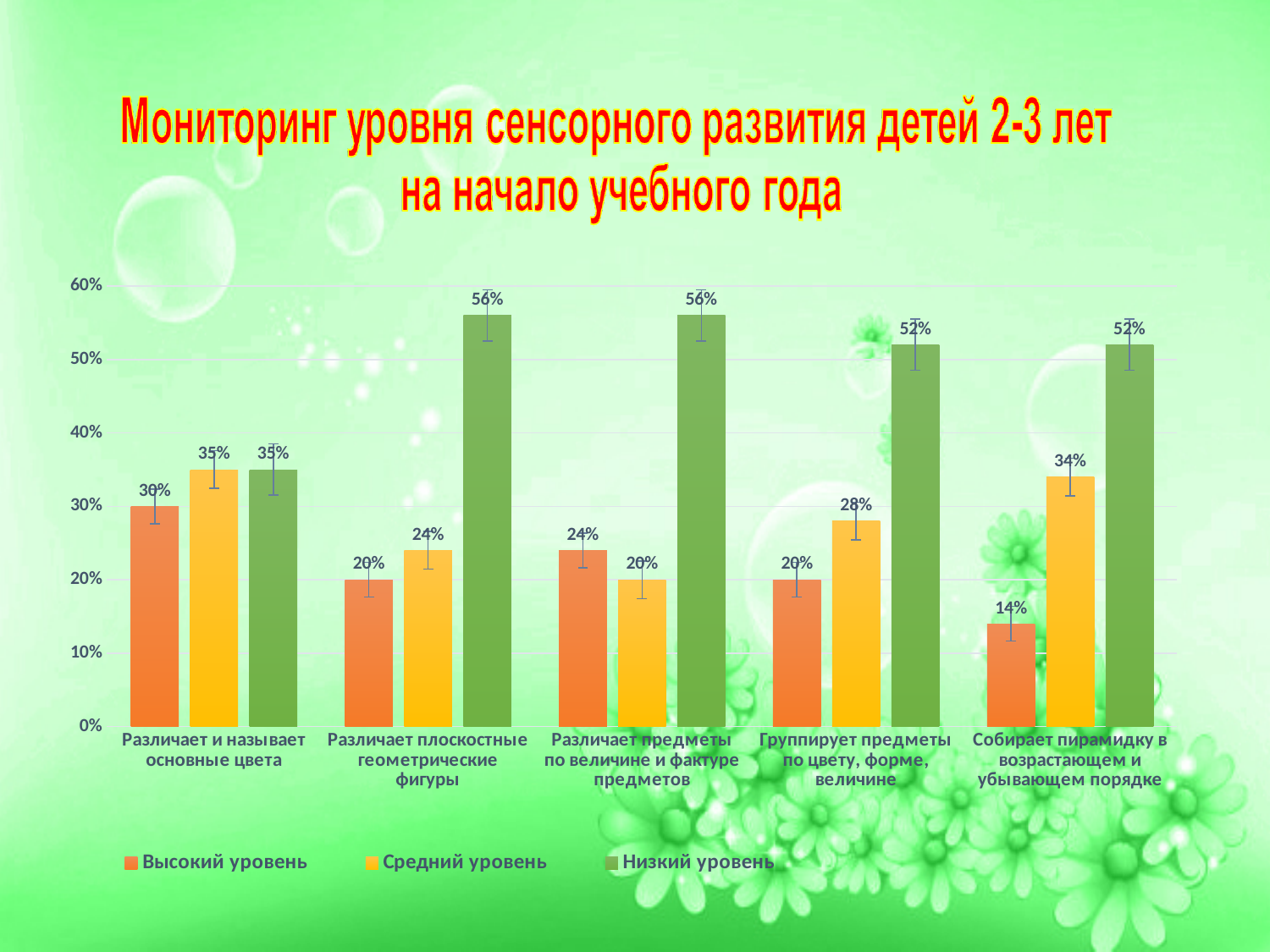
What is the value of Средний уровень for 'Собирает пирамидку в возрастающем и убывающем порядке'? 34% Is the value of Низкий уровень for 'Различает и называет основные цвета' greater or less than 40%? less Which category has the lowest value for Высокий уровень? Собирает пирамидку в возрастающем и убывающем порядке Which is larger for 'Различает предметы по величине и фактуре предметов': Высокий уровень or Средний уровень? Высокий уровень Which category has the highest value for Средний уровень? Различает и называет основные цвета What is the value of Низкий уровень for 'Различает плоскостные геометрические фигуры'? 56% What type of chart is shown on the slide? bar chart How many series does the legend list? 3 What is the difference between Низкий уровень and Высокий уровень for 'Группирует предметы по цвету, форме, величине'? 32% What is the value of Высокий уровень for 'Различает и называет основные цвета'? 30% How many categories are shown on the x axis? 5 What colour are the bars for Низкий уровень? green